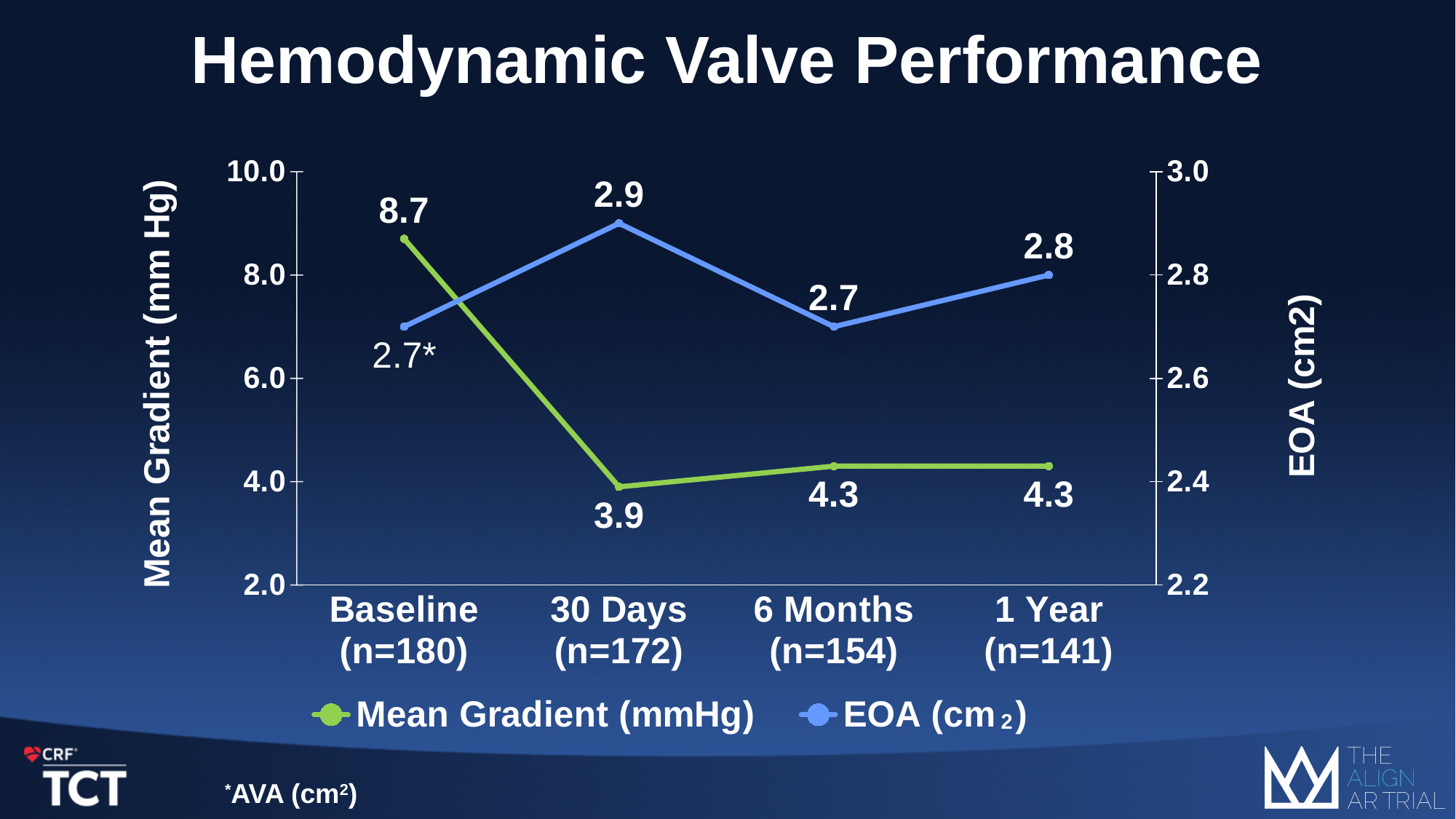
At which time point is the Mean Gradient lowest? 30 Days What kind of chart is shown on the slide? Line chart At which time point is the Mean Gradient highest? Baseline What is the difference between the Mean Gradient at Baseline and at 30 Days? 4.8 Which is larger, the EOA at 30 Days or the EOA at 1 Year? 30 Days How many time points are plotted on the x axis? 4 What is the Mean Gradient value at Baseline? 8.7 At which time point is the EOA highest? 30 Days What is the EOA value at 30 Days? 2.9 How many series does the legend list? 2 What is the EOA value at 6 Months? 2.7 What is the Mean Gradient value at 1 Year? 4.3